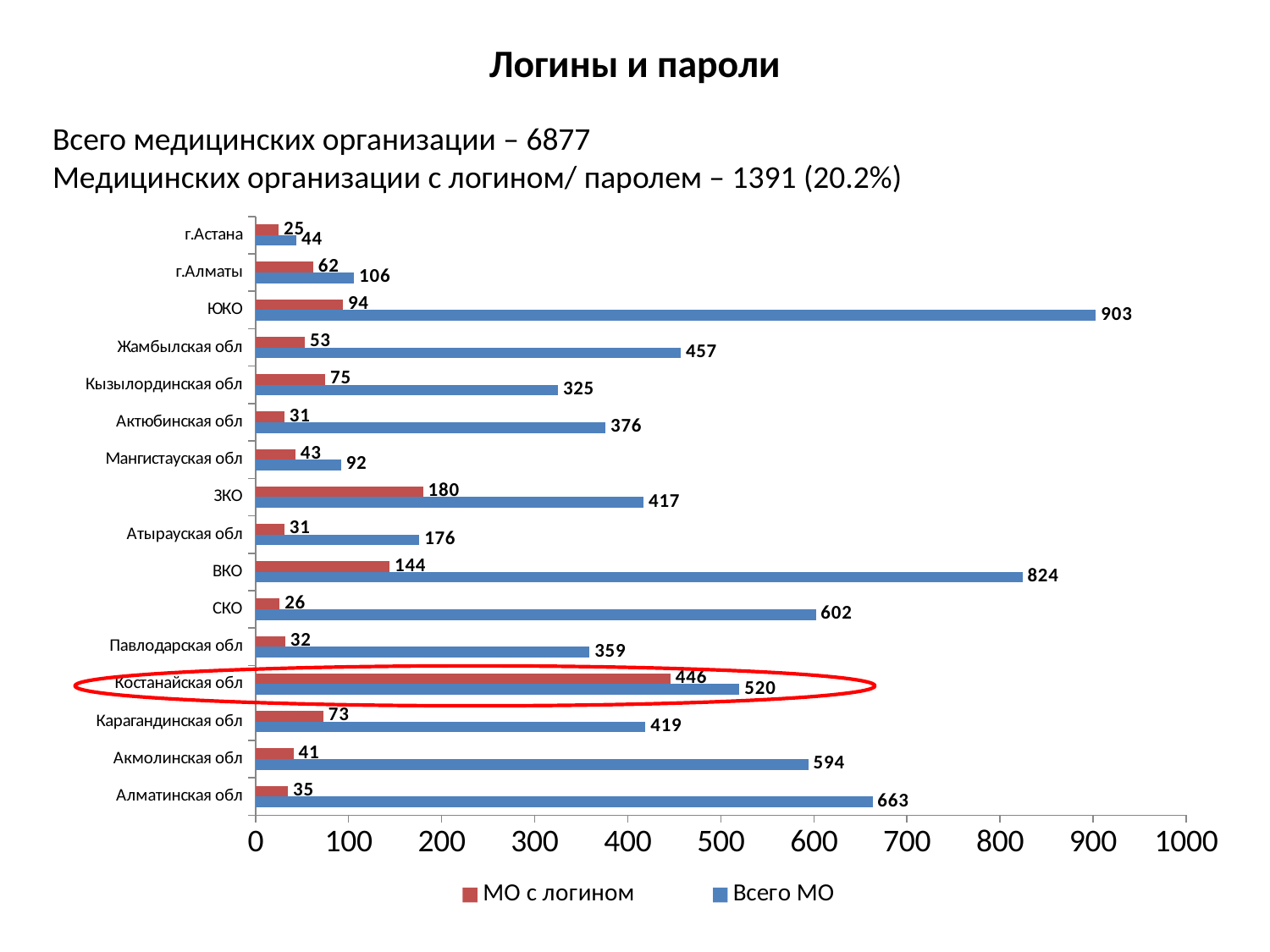
Which category is circled in red on the chart? Костанайская обл How many categories are shown on the chart? 16 Which category has the highest value for "МО с логином"? Костанайская обл What is the value of "МО с логином" for Костанайская обл? 446 Which is larger: "Всего МО" for СКО or "Всего МО" for Жамбылская обл? СКО Which category has the highest value for "Всего МО"? ЮКО What is the difference between "Всего МО" and "МО с логином" for ВКО? 680 What is the value of "Всего МО" for ЮКО? 903 How many series does the legend list? 2 What kind of chart is shown on the slide? Bar chart What is the value of "Всего МО" for Акмолинская обл? 594 Which category has the lowest value for "МО с логином"? г.Астана